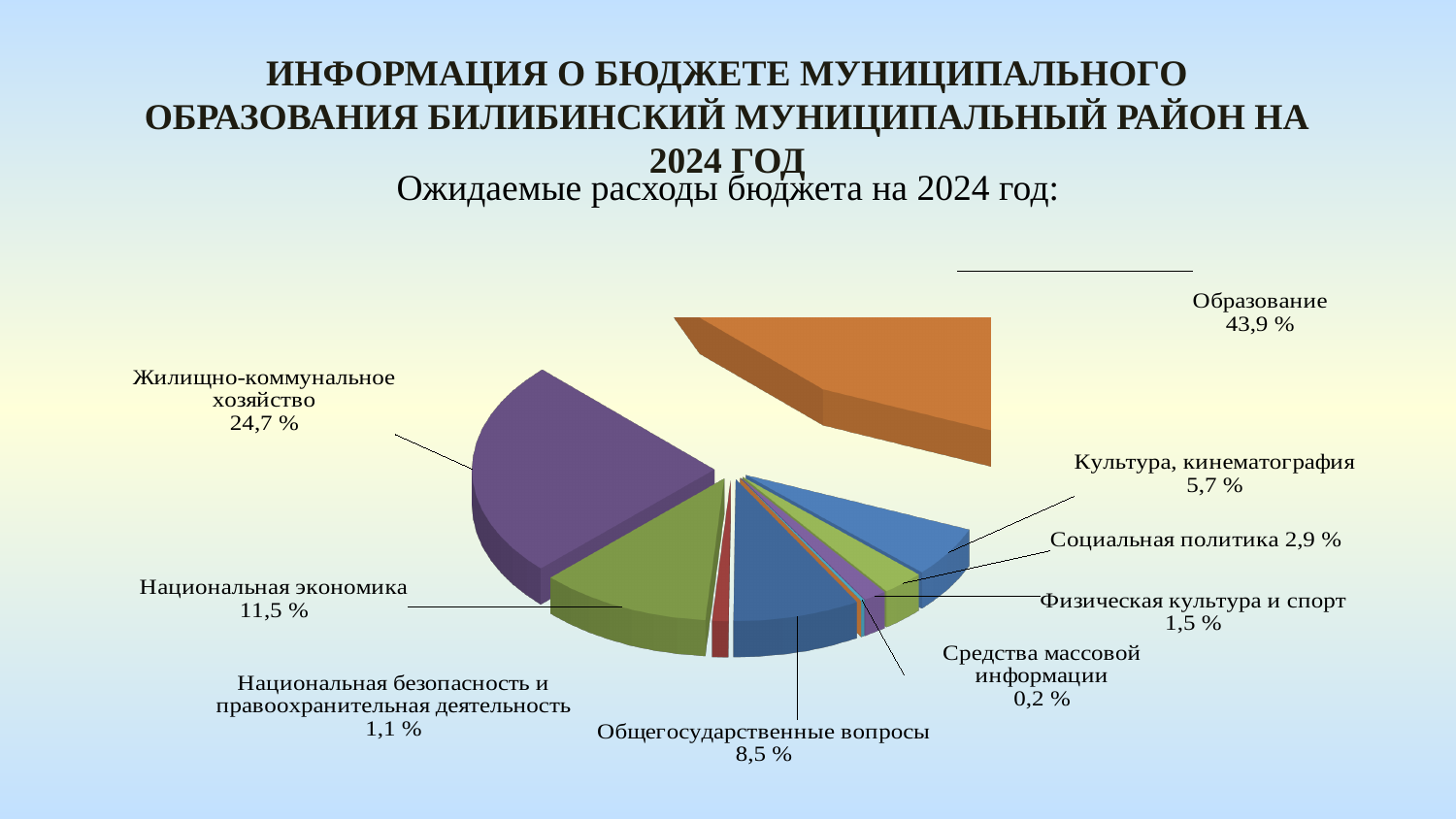
Which is larger: the share for Социальная политика or the share for Физическая культура и спорт? Социальная политика What share of expected 2024 budget expenditures goes to Образование? 43,9 % What kind of chart is shown on the slide? pie chart What is the difference in percentage points between Образование and Жилищно-коммунальное хозяйство? 19,2 Which category has the largest share of the pie? Образование Which labeled category has the smallest share of the pie? Средства массовой информации What share is shown for Общегосударственные вопросы? 8,5 % What share is shown for Национальная экономика? 11,5 % What is the subtitle of the chart on the slide? Ожидаемые расходы бюджета на 2024 год: What share is shown for Жилищно-коммунальное хозяйство? 24,7 % What share is shown for Средства массовой информации? 0,2 % What share is shown for Культура, кинематография? 5,7 %